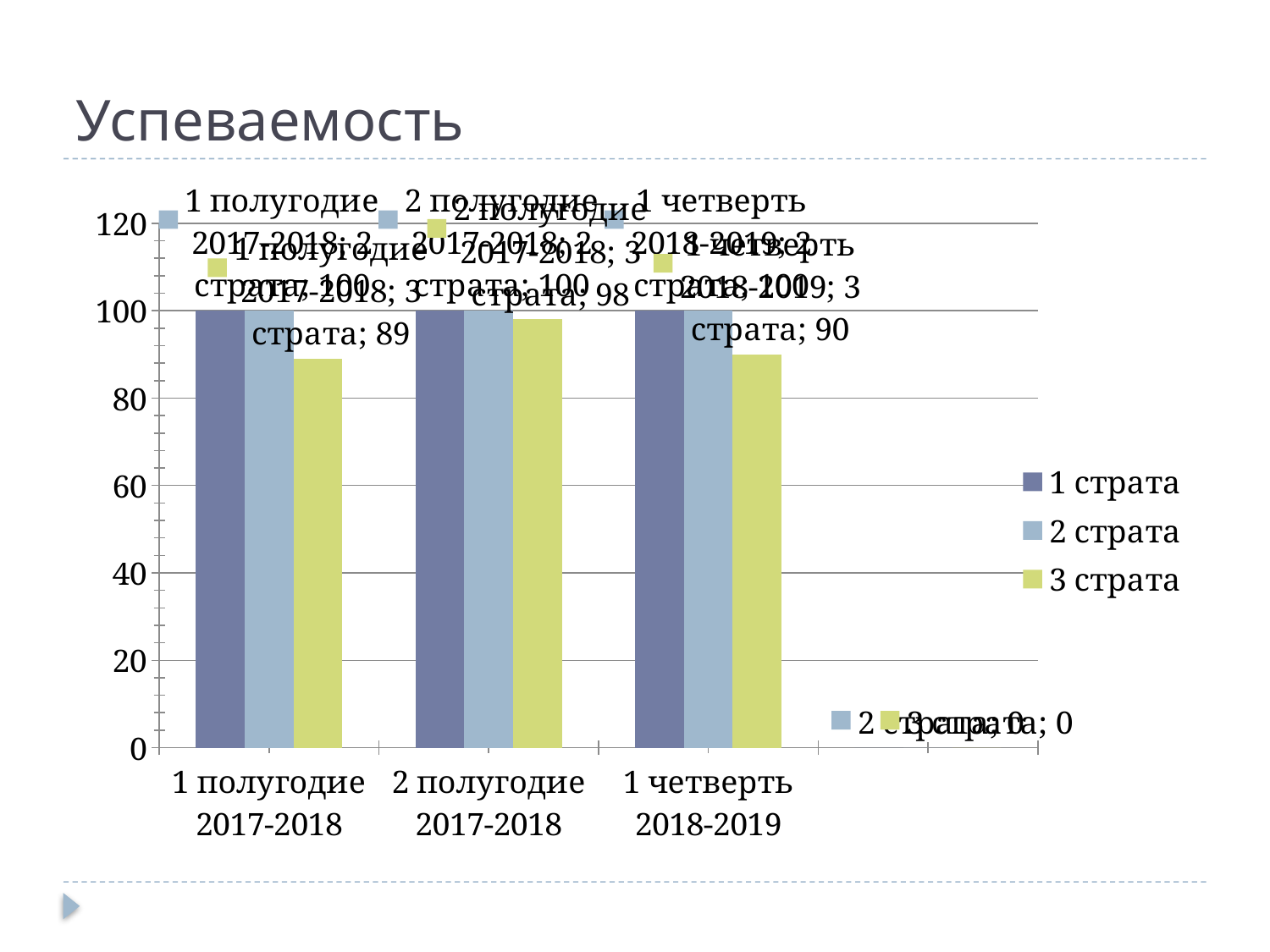
In 1 четверть 2018-2019, which is larger: the value for 2 страта or for 3 страта? 2 страта What is the title of the slide? Успеваемость Is the value for 1 страта in 2 полугодие 2017-2018 greater or less than 80? greater What kind of chart is shown on the slide? Bar chart What is the value for 3 страта in 1 полугодие 2017-2018? 89 What is the value for 3 страта in 1 четверть 2018-2019? 90 What is the value for 2 страта in 1 полугодие 2017-2018? 100 How many series does the legend list? 3 Which period has the lowest value for 3 страта? 1 полугодие 2017-2018 What is the value for 3 страта in 2 полугодие 2017-2018? 98 Which period has the highest value for 3 страта? 2 полугодие 2017-2018 What is the difference between the 3 страта values for 2 полугодие 2017-2018 and 1 полугодие 2017-2018? 9